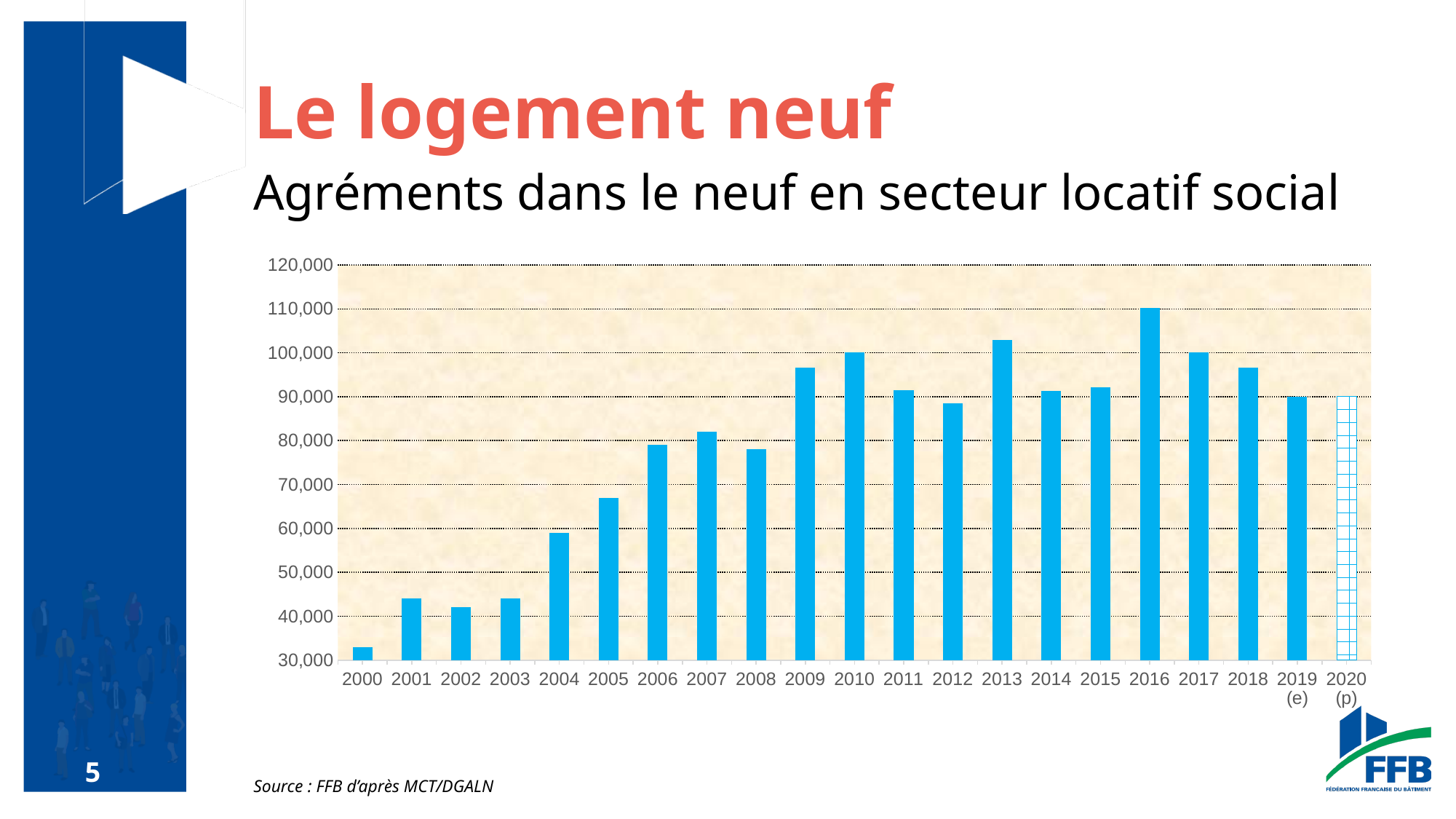
Which year has the lowest value in the chart? 2000 What kind of chart is shown on the slide? bar chart Which year has the highest value in the chart? 2016 What is the subtitle describing the chart on the slide? Agréments dans le neuf en secteur locatif social Is the value for 2000 greater or less than 40,000? less Is the value for 2005 greater or less than 60,000? greater Which is larger, the value for 2013 or the value for 2014? 2013 Do the values rise or fall from 2000 to 2006? rise Is the value for 2008 greater or less than 80,000? less How many years (bars) are shown on the x axis? 21 Which is larger, the value for 2004 or the value for 2006? 2006